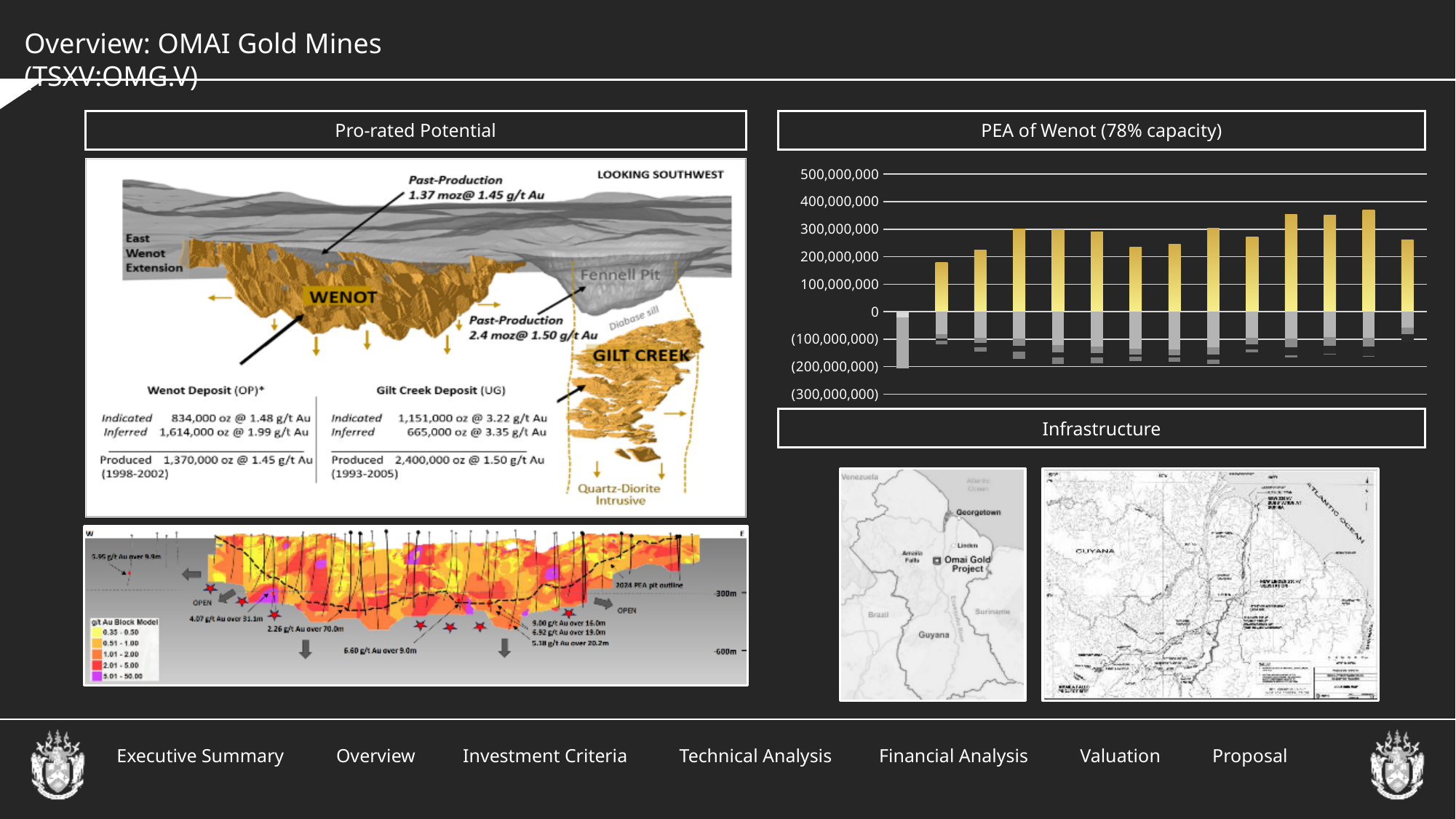
What is the title of the chart on the right side of the slide? PEA of Wenot (78% capacity) In the 'PEA of Wenot (78% capacity)' chart, is the rightmost yellow bar greater or less than 300,000,000? less In the 'PEA of Wenot (78% capacity)' chart, are the yellow bars plotted above or below zero? above In the 'PEA of Wenot (78% capacity)' chart, how many yellow bars are plotted? 13 In the 'PEA of Wenot (78% capacity)' chart, is the tallest yellow bar greater or less than 400,000,000? less What kind of chart is shown under the heading 'PEA of Wenot (78% capacity)'? bar chart In the 'PEA of Wenot (78% capacity)' chart, which is taller: the rightmost yellow bar or the yellow bar second from the right? the yellow bar second from the right In the 'PEA of Wenot (78% capacity)' chart, is the tallest yellow bar greater or less than 300,000,000? greater In the 'PEA of Wenot (78% capacity)' chart, do the yellow bars generally rise or fall from left to right? rise